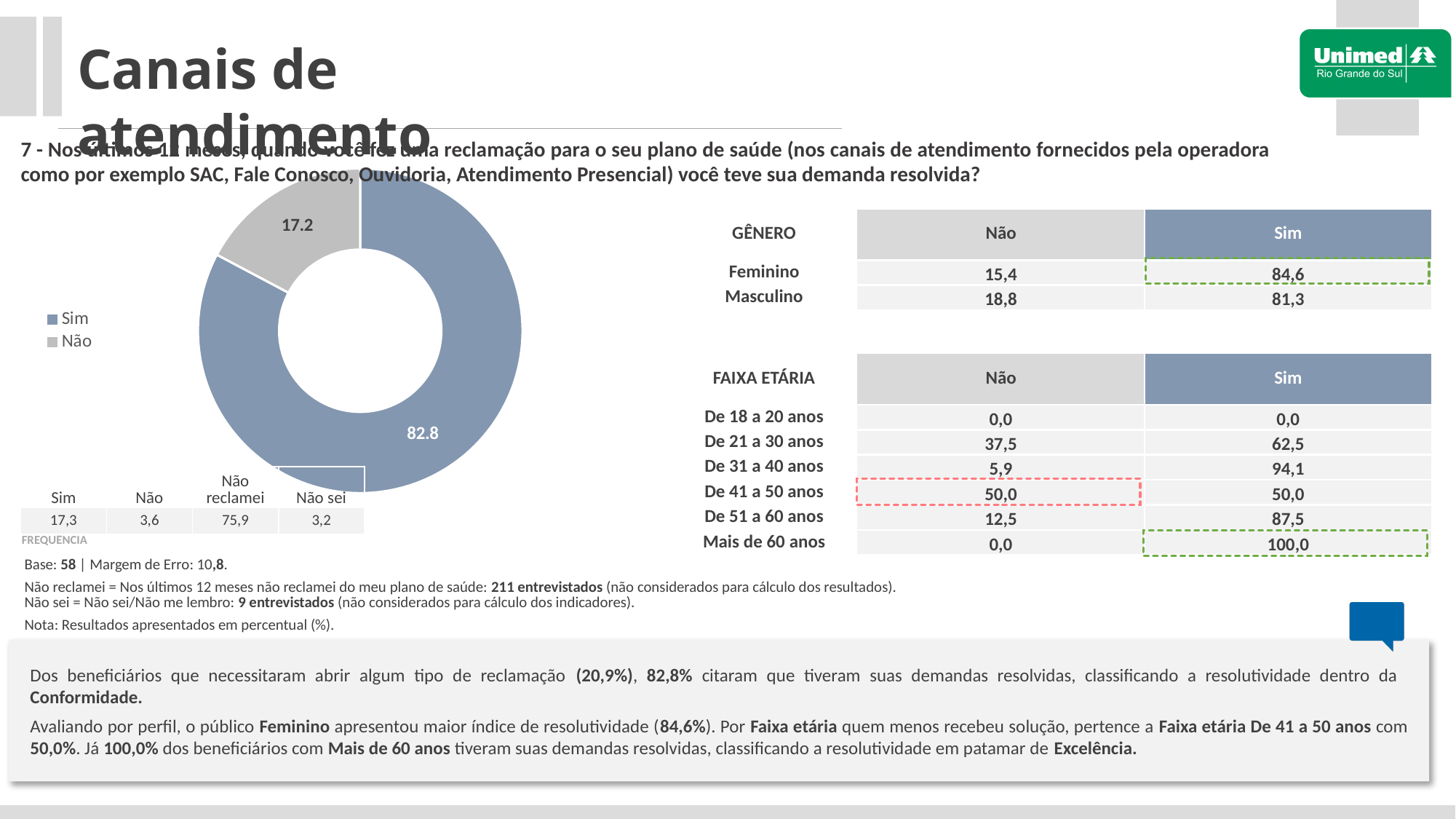
In the pie chart, which is larger: "Sim" or "Não"? Sim How many slices does the pie chart have? 2 Which slice of the pie chart is the smallest? Não What colour is the "Sim" slice in the pie chart? blue What value is shown for the "Sim" slice of the pie chart? 82.8 What kind of chart is shown on the slide? doughnut chart What value is shown for the "Não" slice of the pie chart? 17.2 How many entries does the pie chart's legend list? 2 Which slice of the pie chart is the largest? Sim What are the legend entries of the pie chart? Sim, Não What is the difference between the "Sim" and "Não" values in the pie chart? 65.6